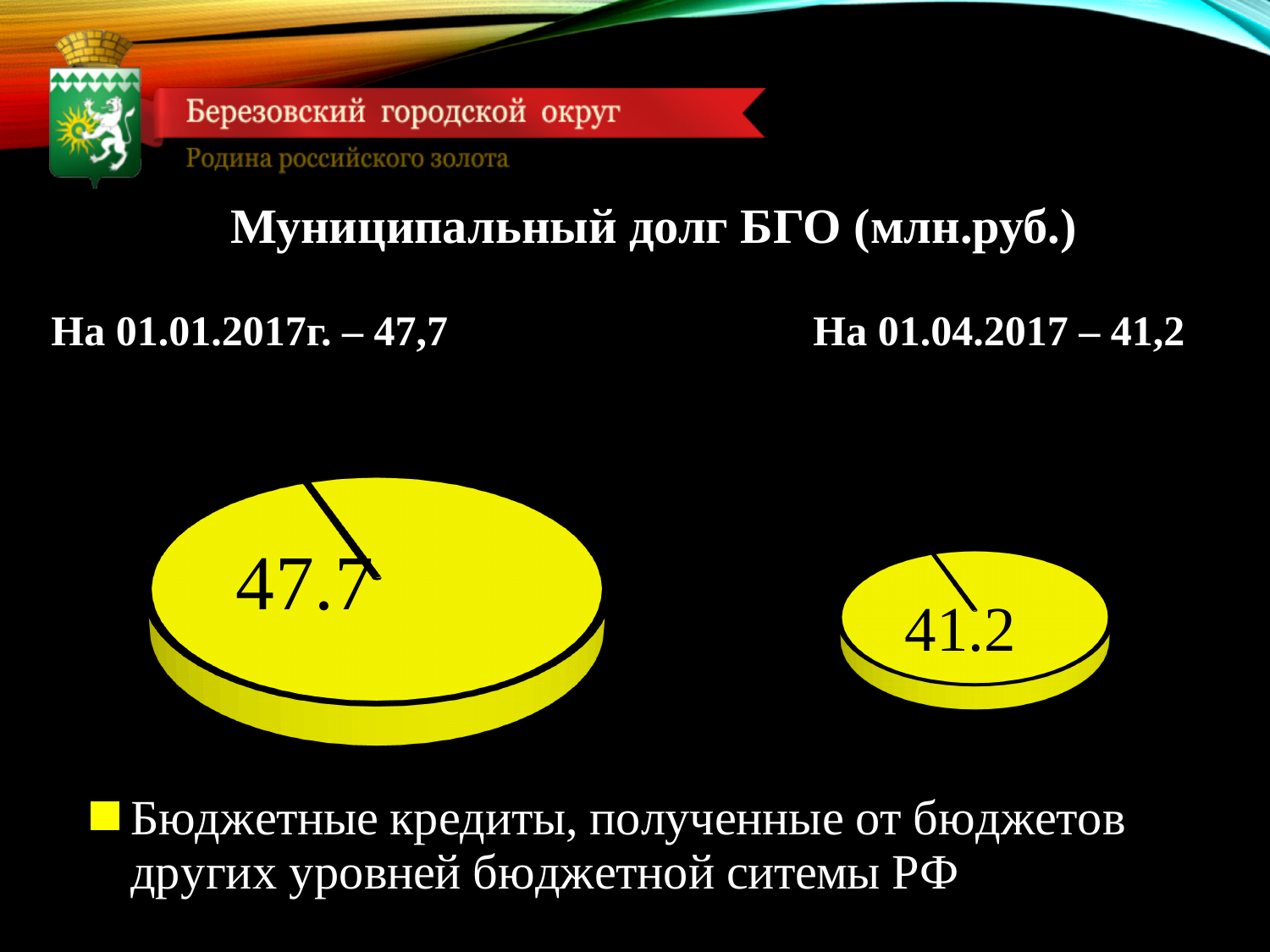
How many entries does the legend list? 1 On the left pie chart (as of 01.01.2017), what value is shown on the slice? 47.7 On the right pie chart (01.04.2017), what share of the pie does the single slice take up? 100% What is the title above the two pie charts? Муниципальный долг БГО (млн.руб.) What is the difference between the value on the left pie chart (47.7) and the value on the right pie chart (41.2)? 6.5 What kind of charts are shown on the slide? pie charts On the right pie chart (as of 01.04.2017), what value is shown on the slice? 41.2 What colour are the slices in both pie charts? yellow Which pie chart shows the larger value, the left one (01.01.2017) or the right one (01.04.2017)? the left one (01.01.2017) How many slices does the left pie chart (01.01.2017) have? 1 Does the municipal debt rise or fall from 01.01.2017 to 01.04.2017 according to the two pie charts? fall